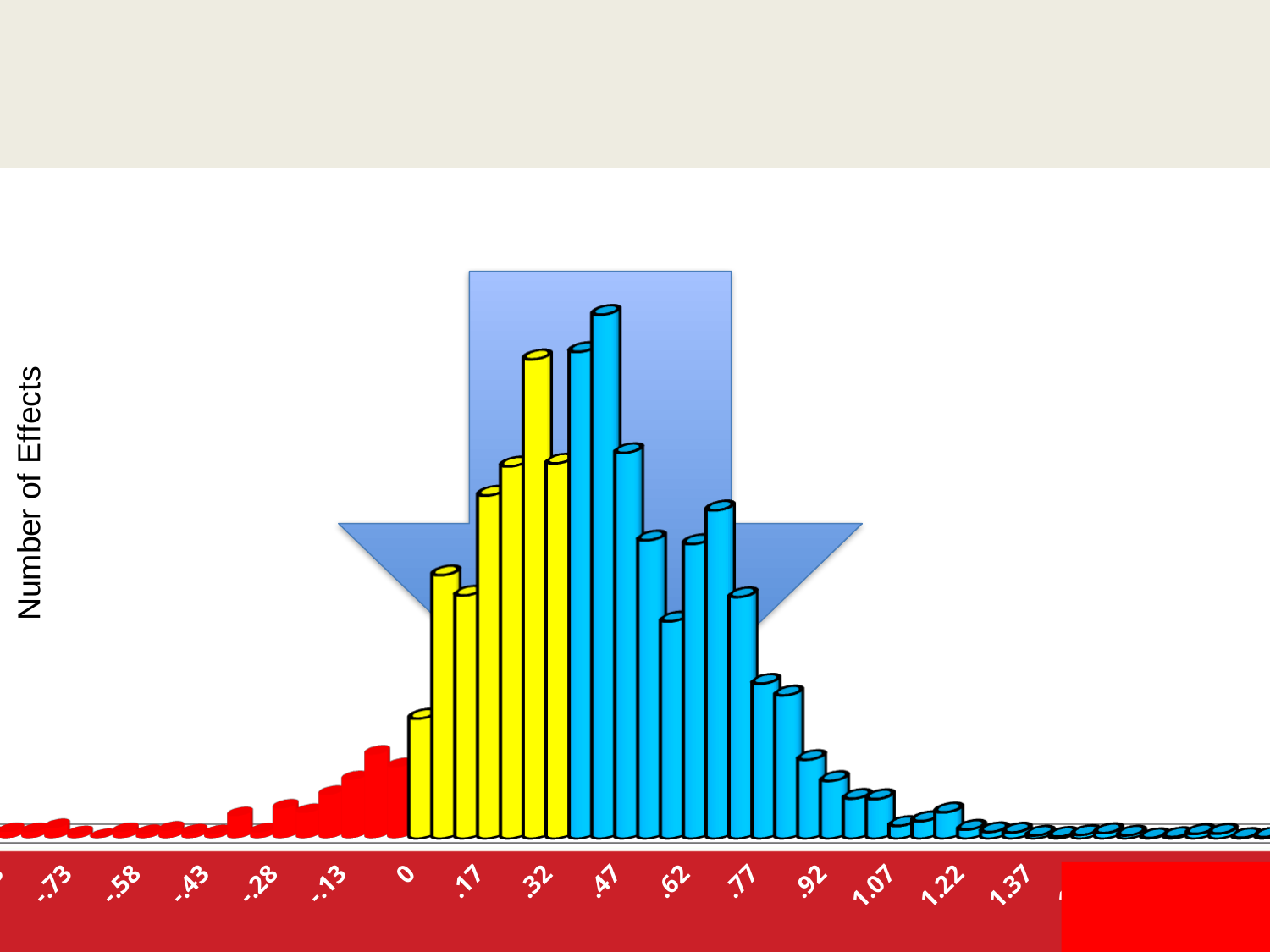
Which bar is taller, the one at -.28 or the one at .92? .92 What colour are the bars to the left of 0 on the x axis? red Which bar is taller, the one at .32 or the one at .62? .32 Which bar is taller, the one at .47 or the one at 0? .47 Do the bar heights rise or fall moving along the x axis from -.73 to .47? rise What kind of chart is shown on the slide? bar chart Do the bar heights rise or fall moving along the x axis from .47 to 1.37? fall What is the title of the vertical axis? Number of Effects